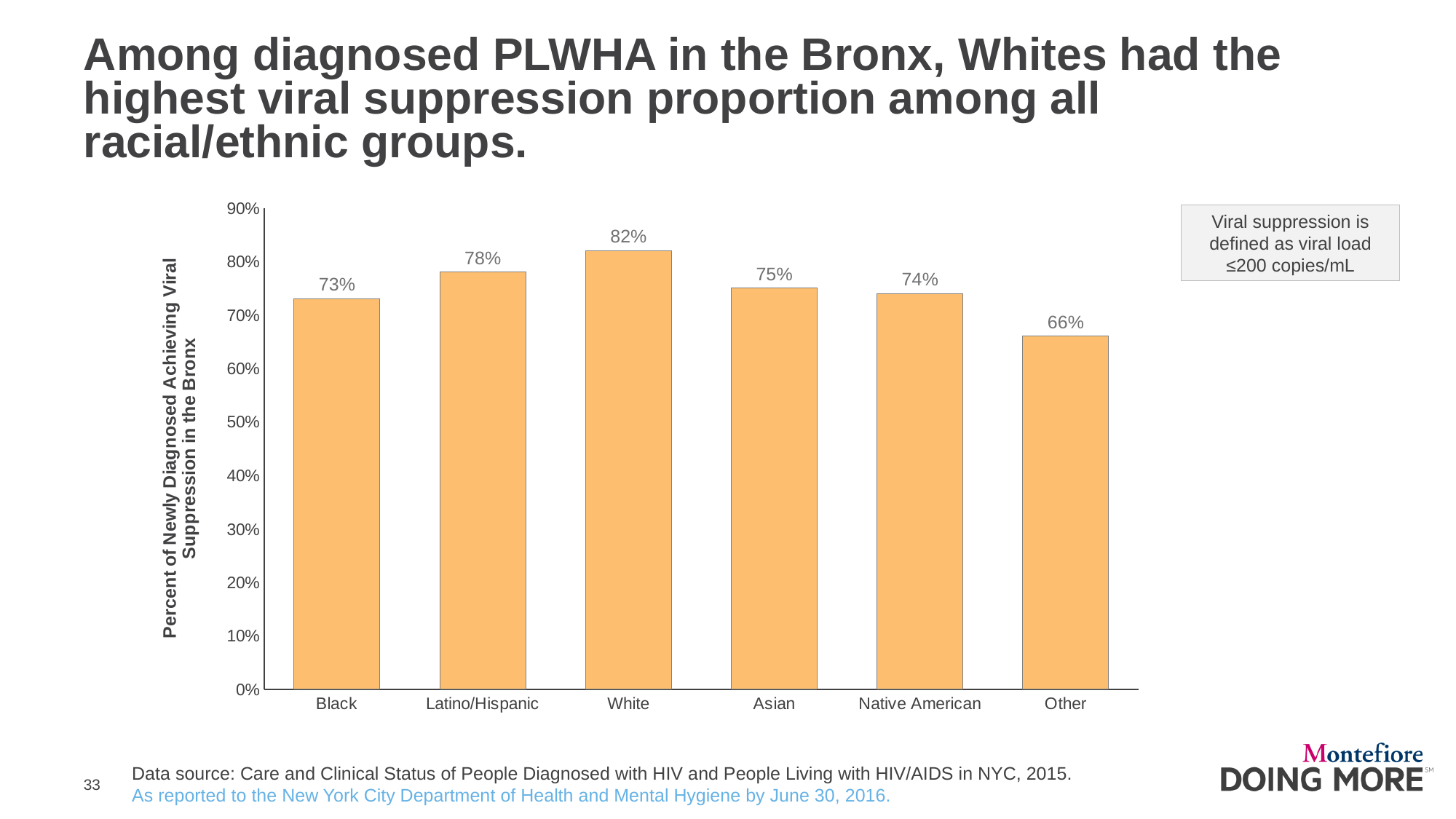
What is the label of the y axis of the chart? Percent of Newly Diagnosed Achieving Viral Suppression in the Bronx What is the difference in viral suppression percentage between the White and Other groups? 16% What is the viral suppression percentage for the Native American group? 74% What is the viral suppression percentage for the Latino/Hispanic group? 78% Which group has a higher viral suppression percentage, Latino/Hispanic or Black? Latino/Hispanic Which racial/ethnic group has the highest viral suppression percentage? White Is the viral suppression percentage for the Other group greater or less than 70%? less How many racial/ethnic groups are shown on the x axis of the chart? 6 What is the viral suppression percentage for the Asian group? 75% Which racial/ethnic group has the lowest viral suppression percentage? Other What type of chart is shown on the slide? bar chart What is the viral suppression percentage for Black newly diagnosed PLWHA in the Bronx? 73%